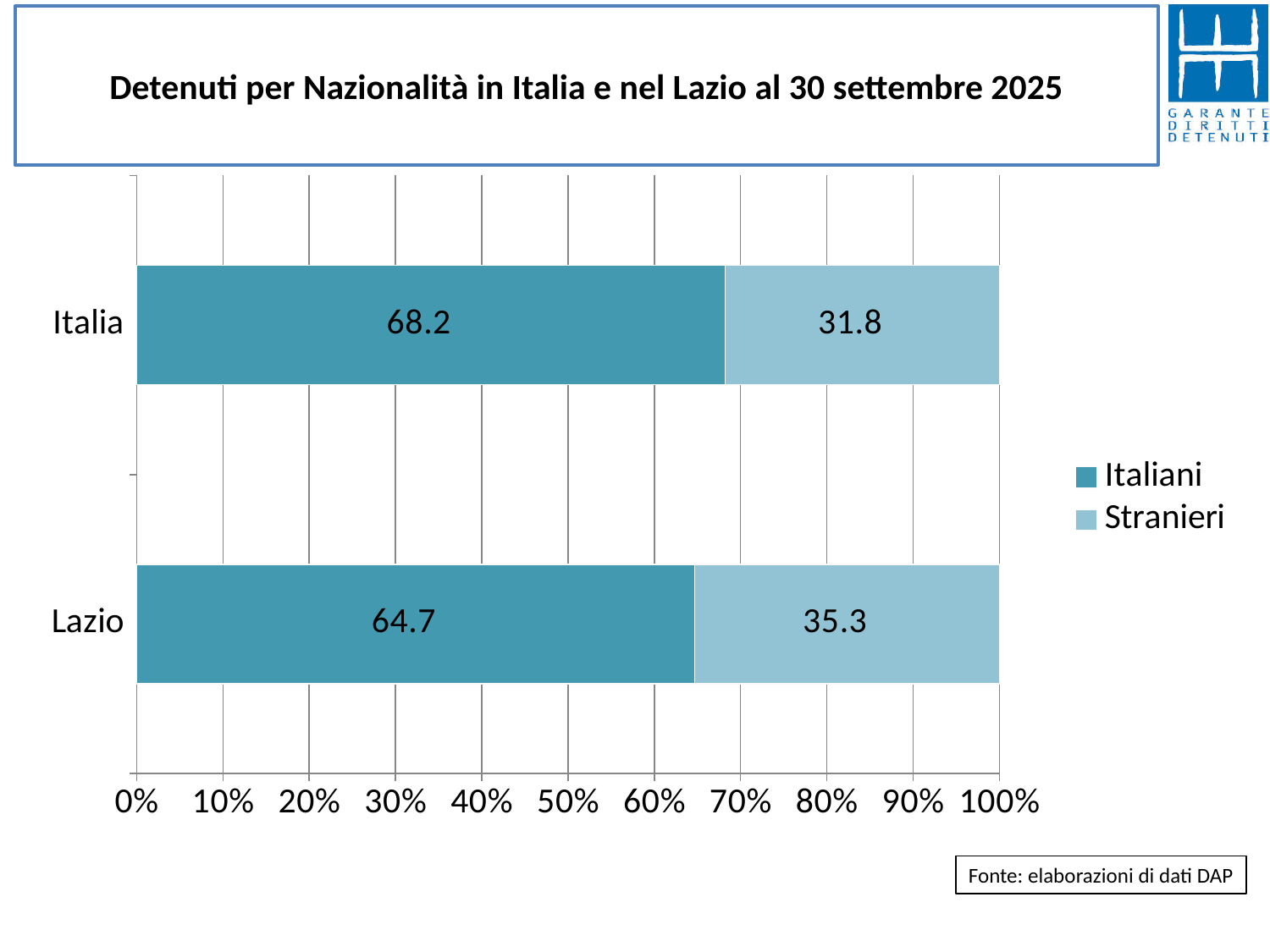
What is the difference between the Italiani values for Italia and Lazio? 3.5 What is the value for Italiani in Italia? 68.2 What is the value for Stranieri in Italia? 31.8 Which category has the higher Italiani value, Italia or Lazio? Italia How many categories are shown on the chart? 2 How many series does the legend list? 2 Which category has the lower Stranieri value? Italia What is the value for Stranieri in Lazio? 35.3 What is the value for Italiani in Lazio? 64.7 What is the title of the chart? Detenuti per Nazionalità in Italia e nel Lazio al 30 settembre 2025 What is the difference between the Stranieri values for Lazio and Italia? 3.5 What kind of chart is shown on the slide? Stacked bar chart